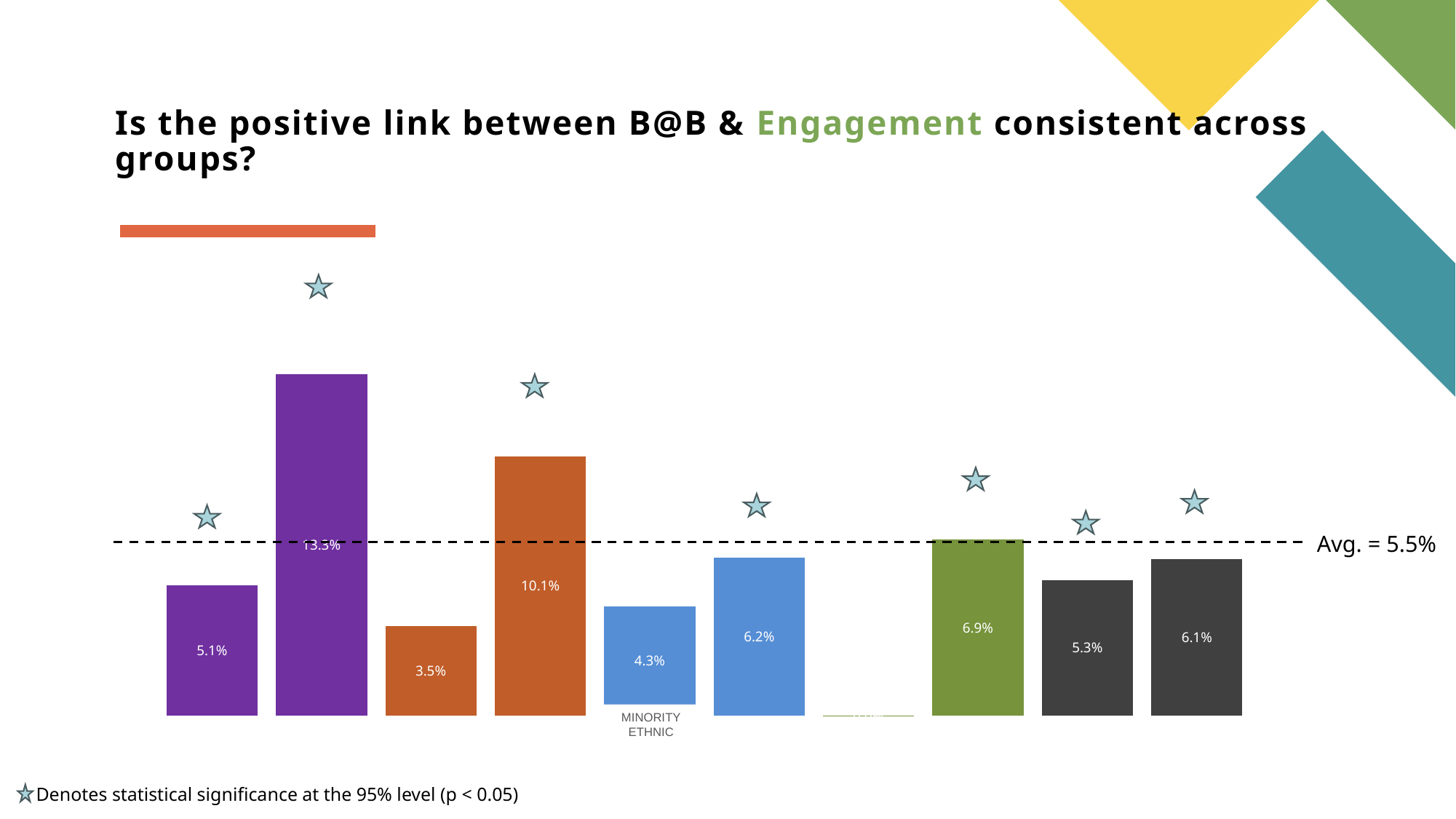
What kind of chart is shown on the slide? bar chart Is the value for the Minority Ethnic group greater or less than the 5.5% average line? less What is the value for the Minority Ethnic group? 4.3% According to the footnote, what does the star symbol denote? Statistical significance at the 95% level (p < 0.05) What is the difference between the highest bar (13.3%) and the Minority Ethnic bar (4.3%)? 9.0% Is the Minority Ethnic bar marked with a star for statistical significance? No What average value is marked by the dashed line on the chart? 5.5% What is the highest value shown on the chart? 13.3% Which is larger, the 6.9% bar or the 5.3% bar? the 6.9% bar How many bars on the chart are marked with a star? 7 What is the difference between the two tallest bars, 13.3% and 10.1%? 3.2%